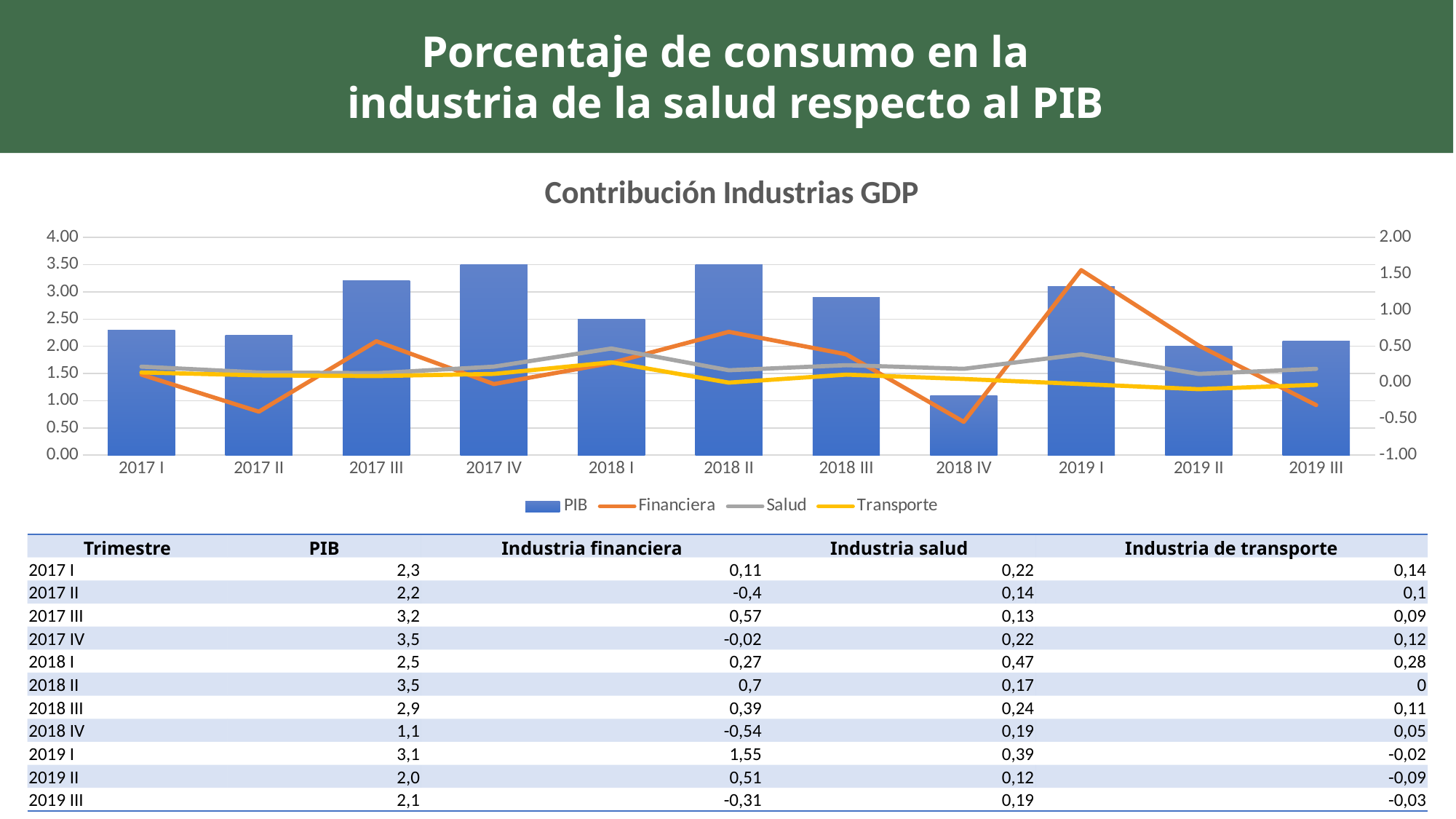
What kind of chart is shown on the slide? A combined bar and line chart What is the title of the chart on the slide? Contribución Industrias GDP In which quarter does the Financiera series reach its highest value? 2019 I How many series does the chart legend list? 4 What is the PIB value for 2017 IV? 3,5 Is the PIB value for 2018 III greater or less than 2.50? greater What is the Industria financiera value for 2019 I? 1,55 In which quarter is the PIB bar lowest? 2018 IV What is the difference between the PIB values for 2017 III and 2017 I? 0,9 Which is larger, the PIB value for 2018 I or for 2019 II? 2018 I In which quarter does the Financiera series reach its lowest value? 2018 IV How many quarters are shown along the x axis of the chart? 11